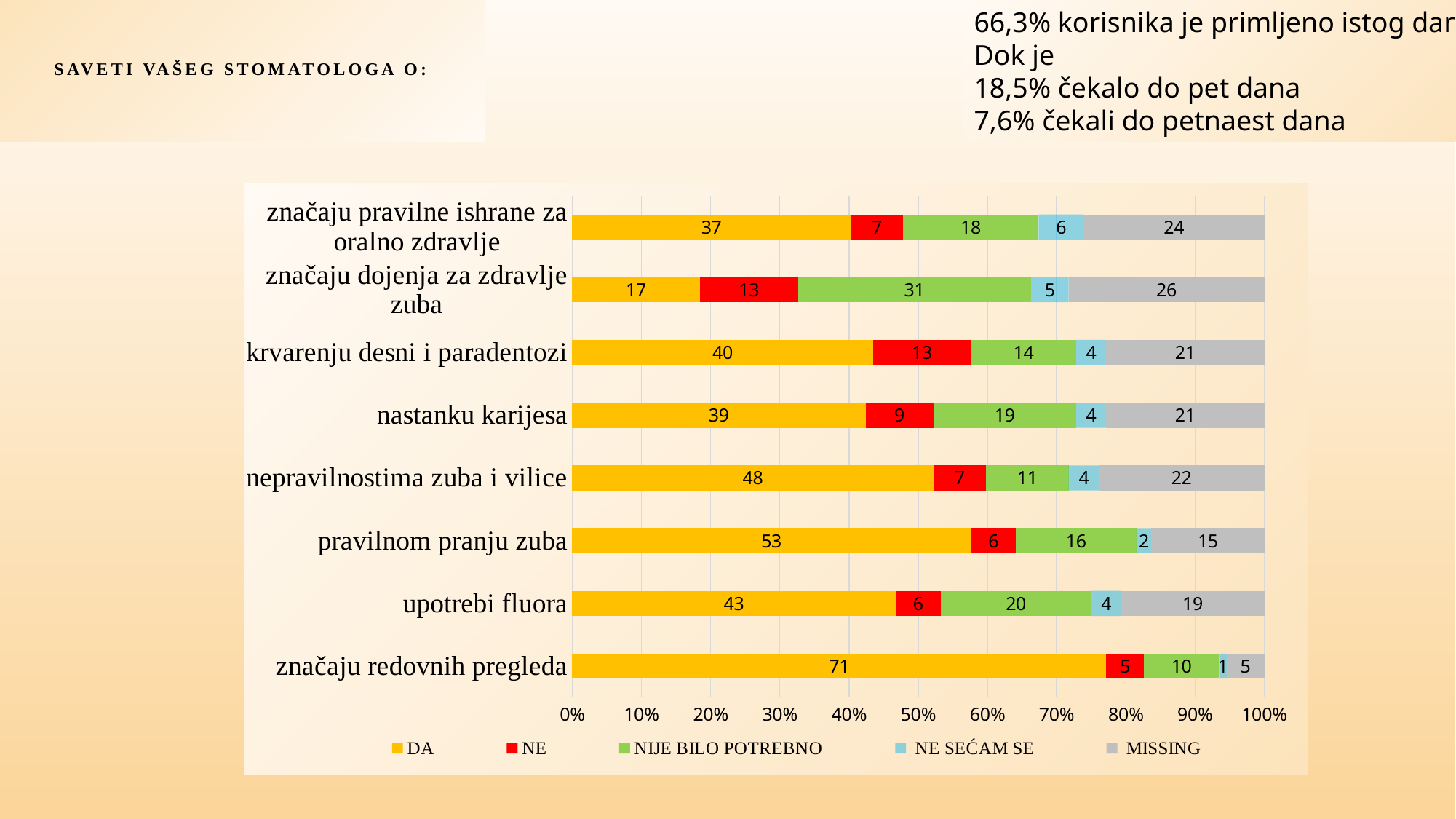
What is the MISSING value for "pravilnom pranju zuba"? 15 What is the DA value for "značaju redovnih pregleda"? 71 What is the total of all segments in the bar for "nepravilnostima zuba i vilice"? 92 Which series is shown in red in the legend? NE What is the NIJE BILO POTREBNO value for "značaju dojenja za zdravlje zuba"? 31 Which category has the lowest DA value? značaju dojenja za zdravlje zuba Which category has the highest DA value? značaju redovnih pregleda What is the difference between the DA values for "pravilnom pranju zuba" and "upotrebi fluora"? 10 What kind of chart is shown on the slide? stacked bar chart How many categories are shown on the chart? 8 Which is larger: the NE value for "krvarenju desni i paradentozi" or the NE value for "nastanku karijesa"? krvarenju desni i paradentozi How many series does the legend list? 5